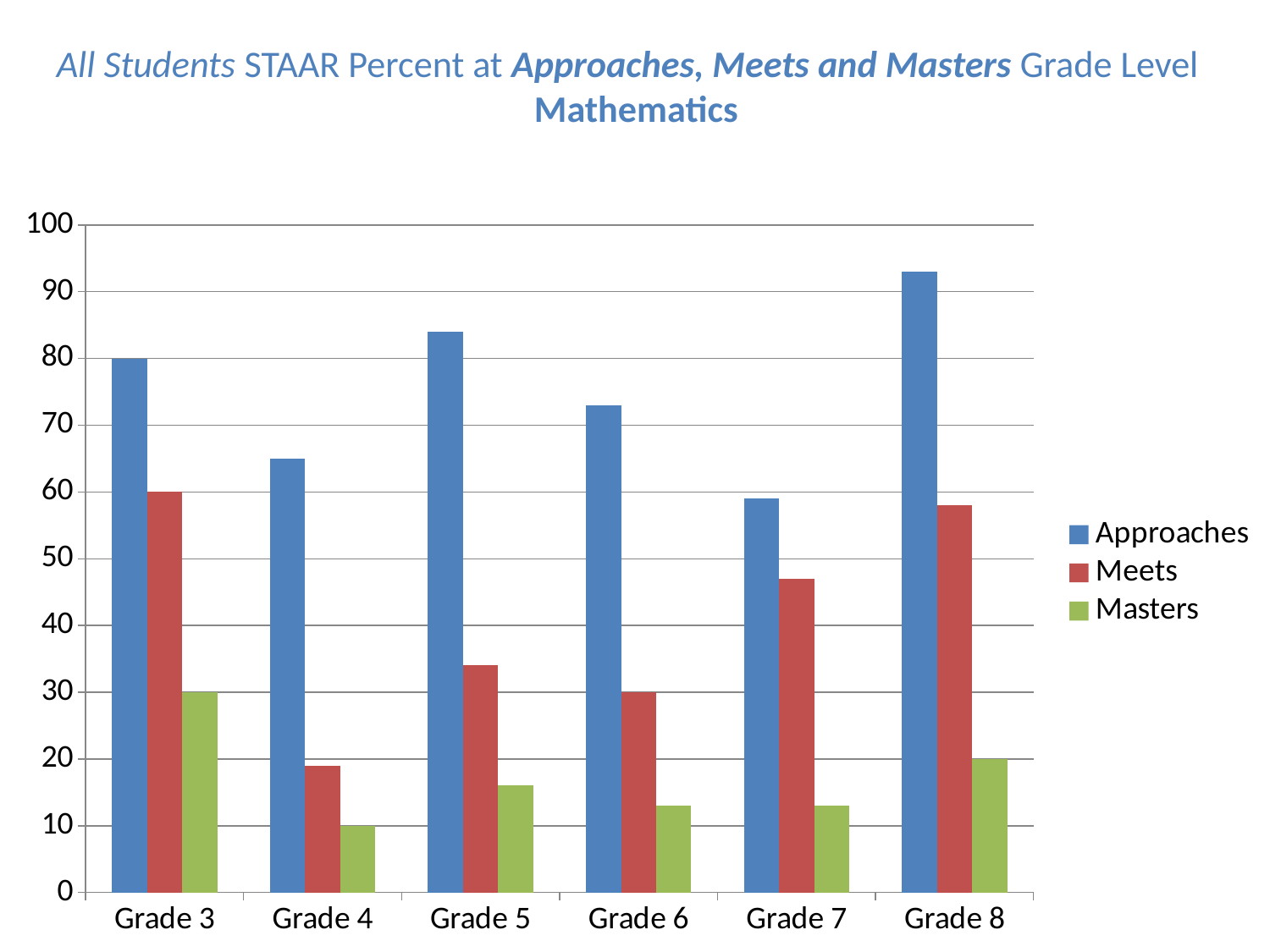
What is the Masters value for Grade 4? 10 Is the Approaches value for Grade 5 greater or less than 80? greater What is the Meets value for Grade 3? 60 What is the Approaches value for Grade 3? 80 How many series does the legend list? 3 What kind of chart is shown on the slide? bar chart Which grade has the highest Approaches value? Grade 8 Is the Meets value for Grade 7 greater or less than 50? less Which grade has the lowest Meets value? Grade 4 Which is larger, the Masters value for Grade 3 or the Masters value for Grade 8? Grade 3 How many grade categories are shown on the x axis? 6 Which grade has the lowest Approaches value? Grade 7